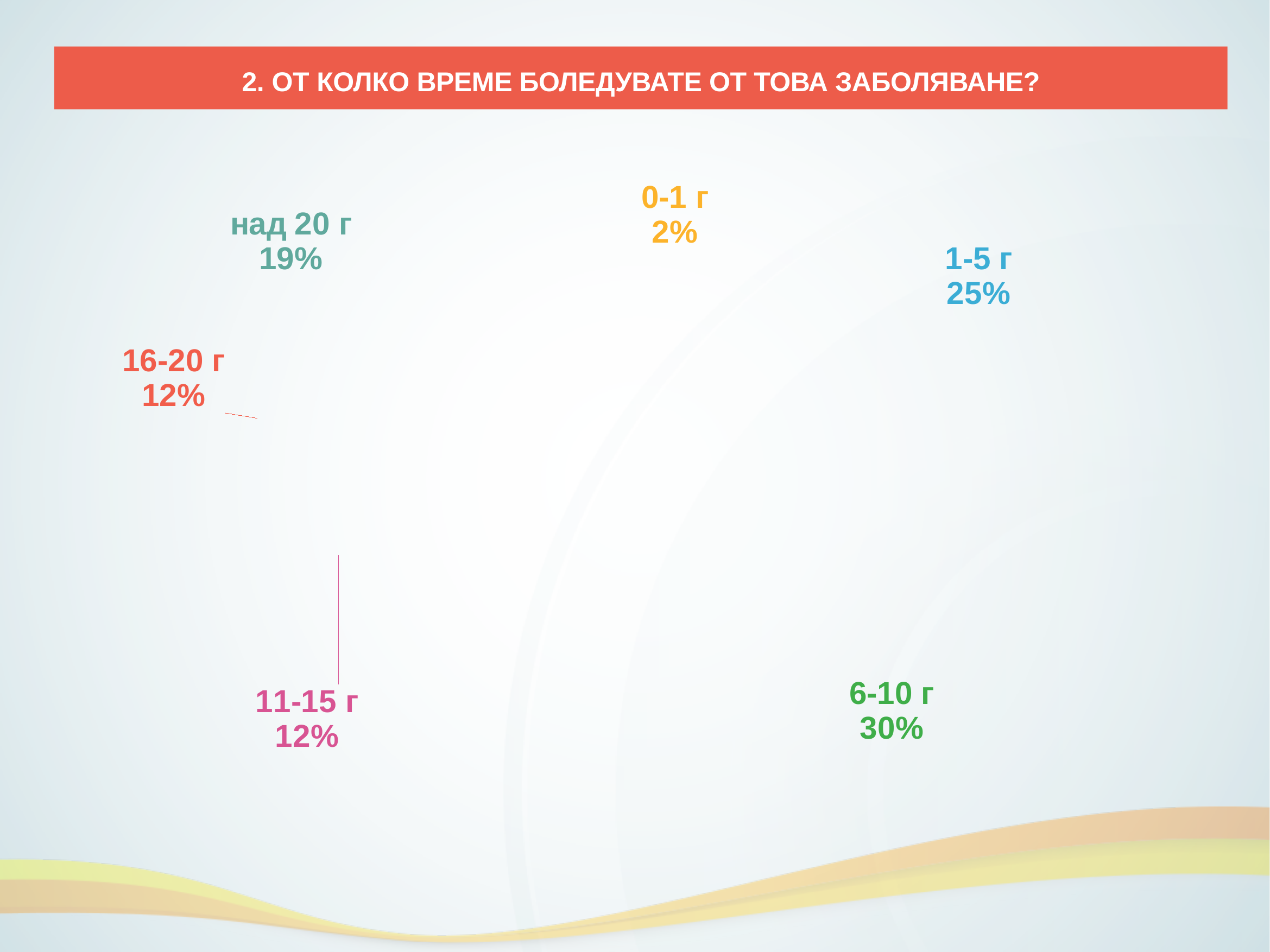
How many categories are labelled on the chart? 6 Which category has the lowest percentage? 0-1 г What percentage is shown for the category "1-5 г"? 25% What is the difference in percentage points between "6-10 г" and "1-5 г"? 5 Which category has the highest percentage? 6-10 г What percentage is shown for the category "0-1 г"? 2% What percentage is shown for the category "6-10 г"? 30% Which is larger, the value for "над 20 г" or the value for "16-20 г"? над 20 г What is the title of the slide? 2. ОТ КОЛКО ВРЕМЕ БОЛЕДУВАТЕ ОТ ТОВА ЗАБОЛЯВАНЕ? What percentage is shown for the category "16-20 г"? 12% What percentage is shown for the category "над 20 г"? 19% What is the combined percentage of "11-15 г" and "16-20 г"? 24%